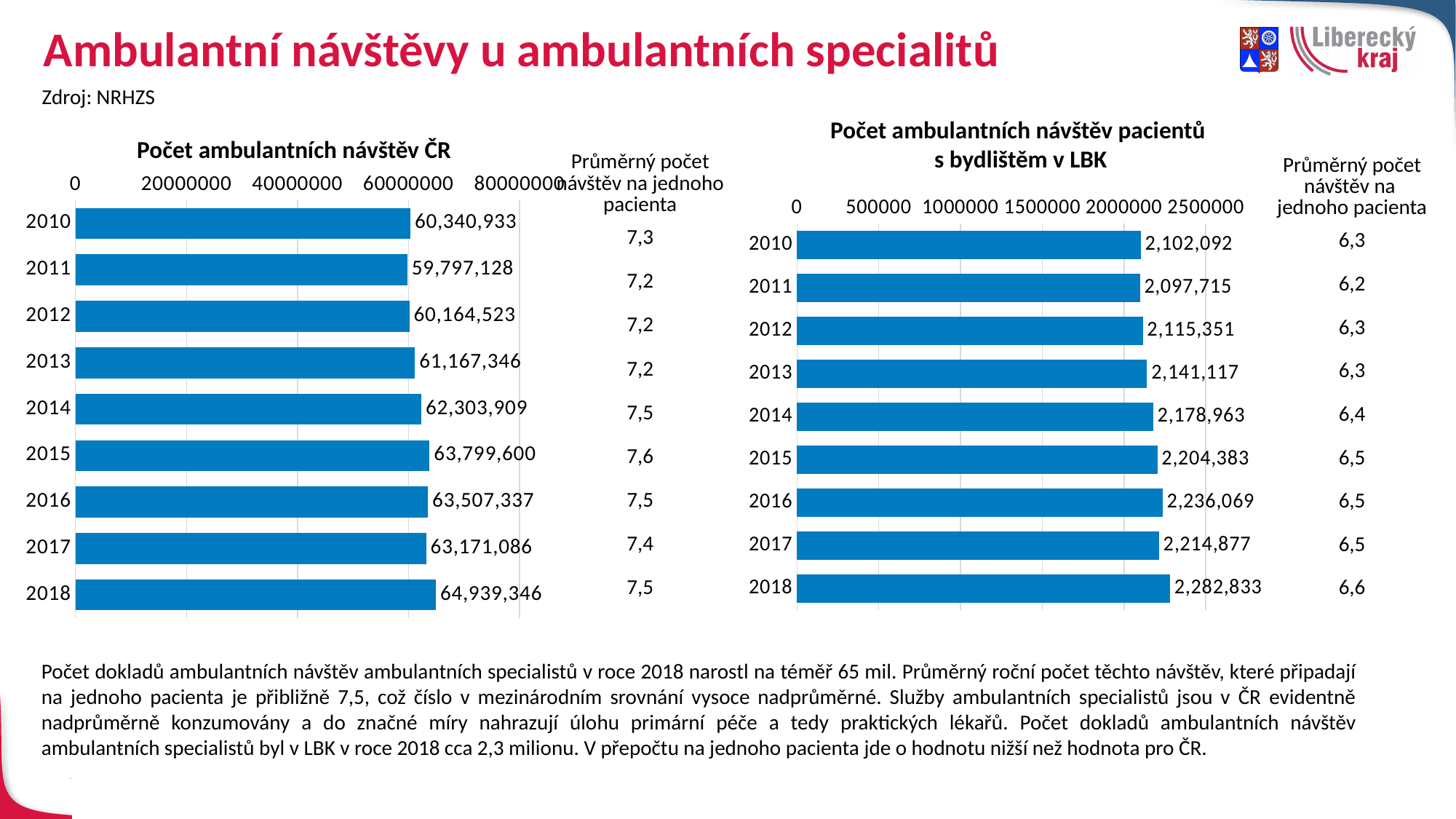
In the chart 'Počet ambulantních návštěv ČR', what is the difference between the values for 2018 and 2010? 4,598,413 How many years are shown in the chart 'Počet ambulantních návštěv ČR'? 9 In the chart 'Počet ambulantních návštěv pacientů s bydlištěm v LBK', is the value for 2010 greater or less than 2000000? greater In the chart 'Počet ambulantních návštěv pacientů s bydlištěm v LBK', what is the value for 2014? 2,178,963 In the chart 'Počet ambulantních návštěv pacientů s bydlištěm v LBK', which year has the lowest value? 2011 In the chart 'Počet ambulantních návštěv ČR', which year has the highest value? 2018 In the chart 'Počet ambulantních návštěv ČR', which year has the lowest value? 2011 What is the title of the chart on the left side of the slide? Počet ambulantních návštěv ČR In the chart 'Počet ambulantních návštěv pacientů s bydlištěm v LBK', what is the difference between the values for 2018 and 2010? 180,741 What kind of chart is 'Počet ambulantních návštěv pacientů s bydlištěm v LBK'? bar chart In the chart 'Počet ambulantních návštěv ČR', which is larger, the value for 2015 or the value for 2017? 2015 In the chart 'Počet ambulantních návštěv ČR', what is the value for 2018? 64,939,346